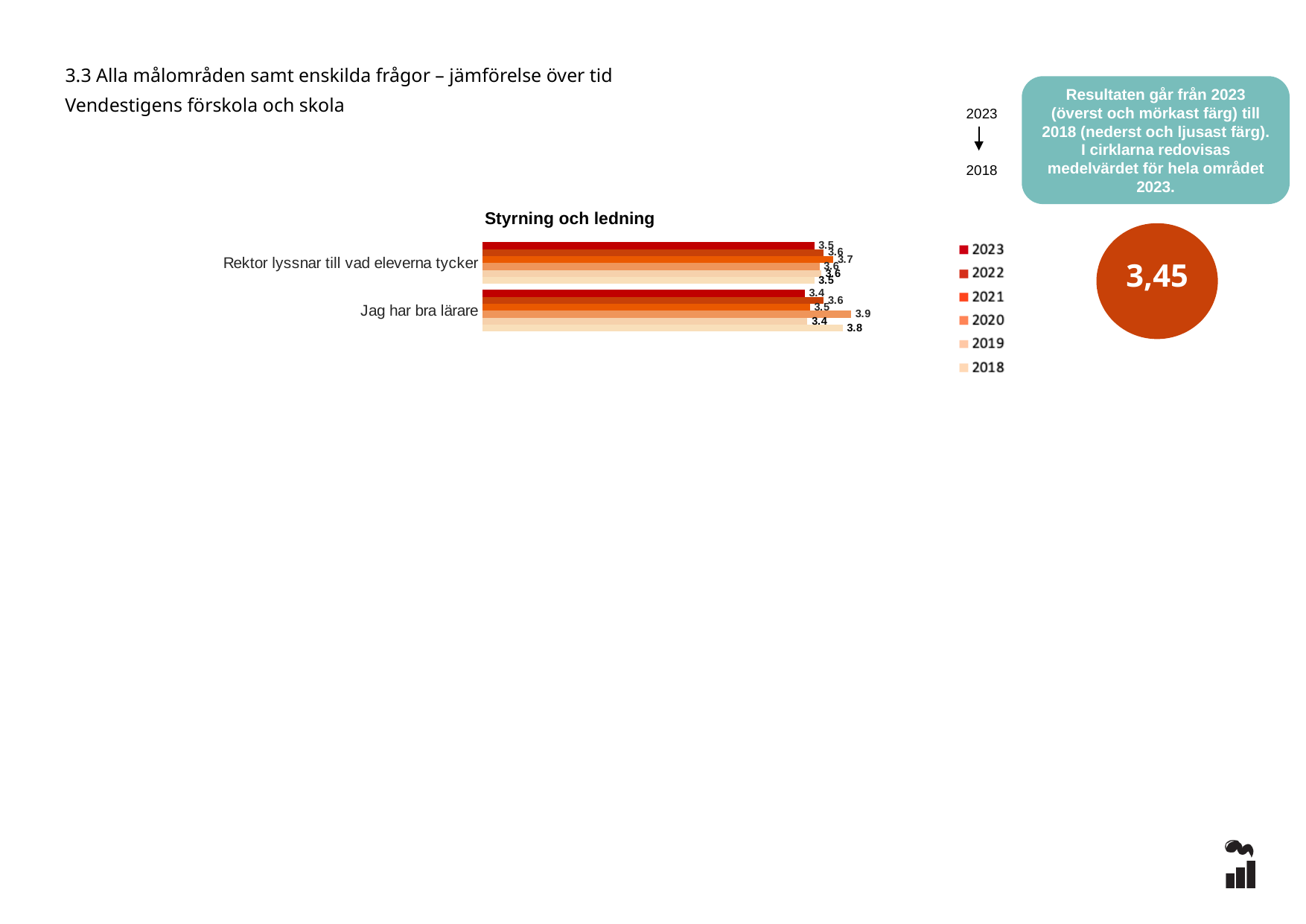
How many series does the legend of the "Styrning och ledning" chart list? 6 In the "Styrning och ledning" chart, what is the 2023 value for "Jag har bra lärare"? 3.4 How many categories (questions) are plotted in the "Styrning och ledning" chart? 2 In the "Styrning och ledning" chart, what is the difference between the 2020 and 2023 values for "Jag har bra lärare"? 0.5 In the "Styrning och ledning" chart, what is the 2023 value for "Rektor lyssnar till vad eleverna tycker"? 3.5 What mean value for the whole area in 2023 is shown in the circle next to the "Styrning och ledning" chart? 3,45 In the "Styrning och ledning" chart, what is the 2018 value for "Jag har bra lärare"? 3.8 In the "Styrning och ledning" chart, which year has the highest value for "Jag har bra lärare"? 2020 What kind of chart is shown under the title "Styrning och ledning"? bar chart In the "Styrning och ledning" chart, what is the 2021 value for "Rektor lyssnar till vad eleverna tycker"? 3.7 In the "Styrning och ledning" chart, what is the 2020 value for "Jag har bra lärare"? 3.9 In the "Styrning och ledning" chart, which is larger for 2023: "Rektor lyssnar till vad eleverna tycker" or "Jag har bra lärare"? Rektor lyssnar till vad eleverna tycker